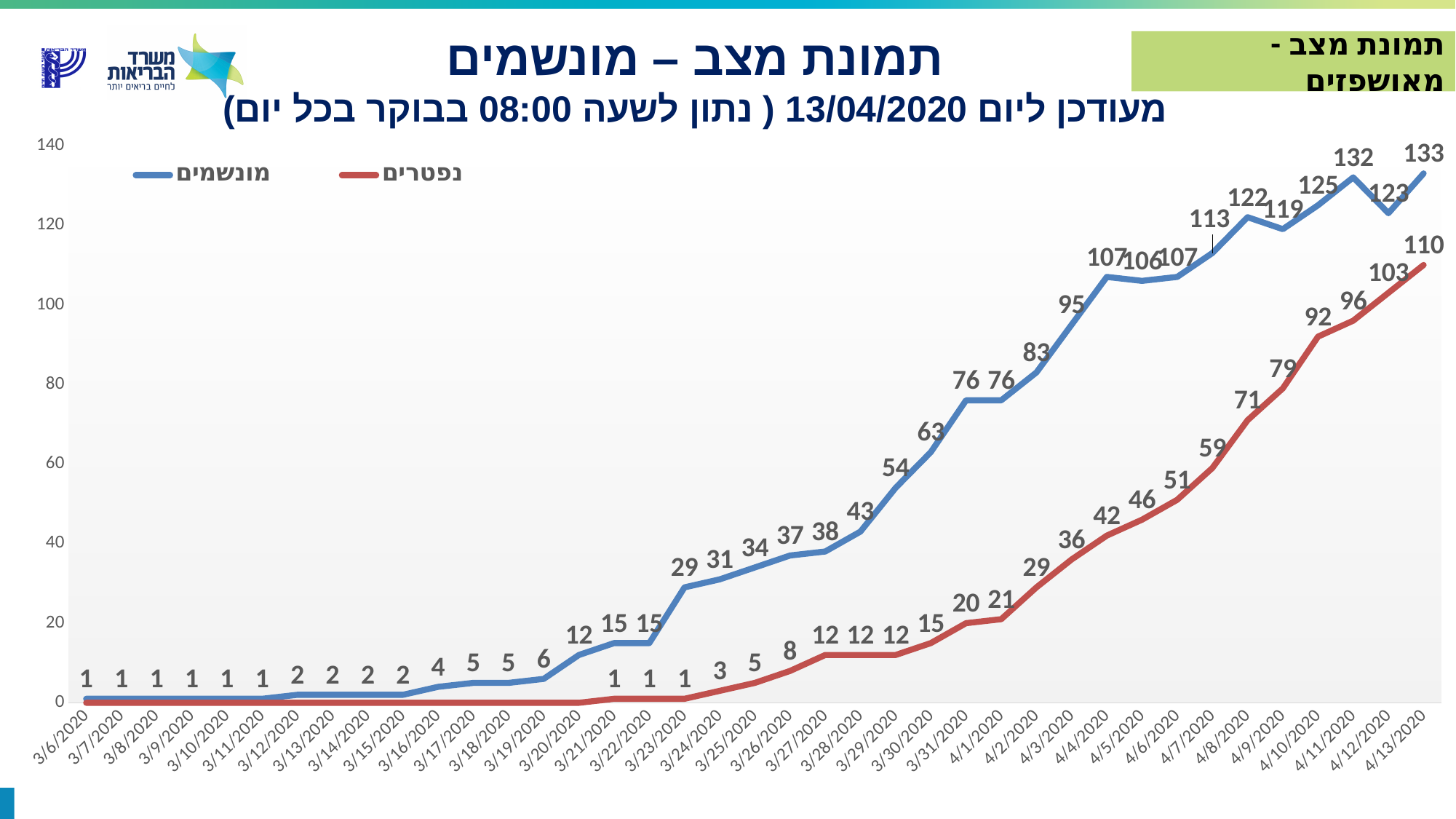
What is the difference between the מונשמים and נפטרים values on 4/13/2020? 23 What is the difference between the מונשמים values on 4/11/2020 and 4/12/2020? 9 What is the value of the נפטרים series on 4/13/2020? 110 Does the נפטרים series generally rise or fall from 3/21/2020 to 4/13/2020? rise What type of chart is shown on the slide? line chart Which series is drawn in red? נפטרים What is the value of the מונשמים series on 3/23/2020? 29 On which date does the מונשמים series reach its highest value? 4/13/2020 Which series has the larger value on 4/4/2020, מונשמים or נפטרים? מונשמים How many series does the legend list? 2 What is the value of the נפטרים series on 4/8/2020? 71 What is the value of the מונשמים series on 4/13/2020? 133